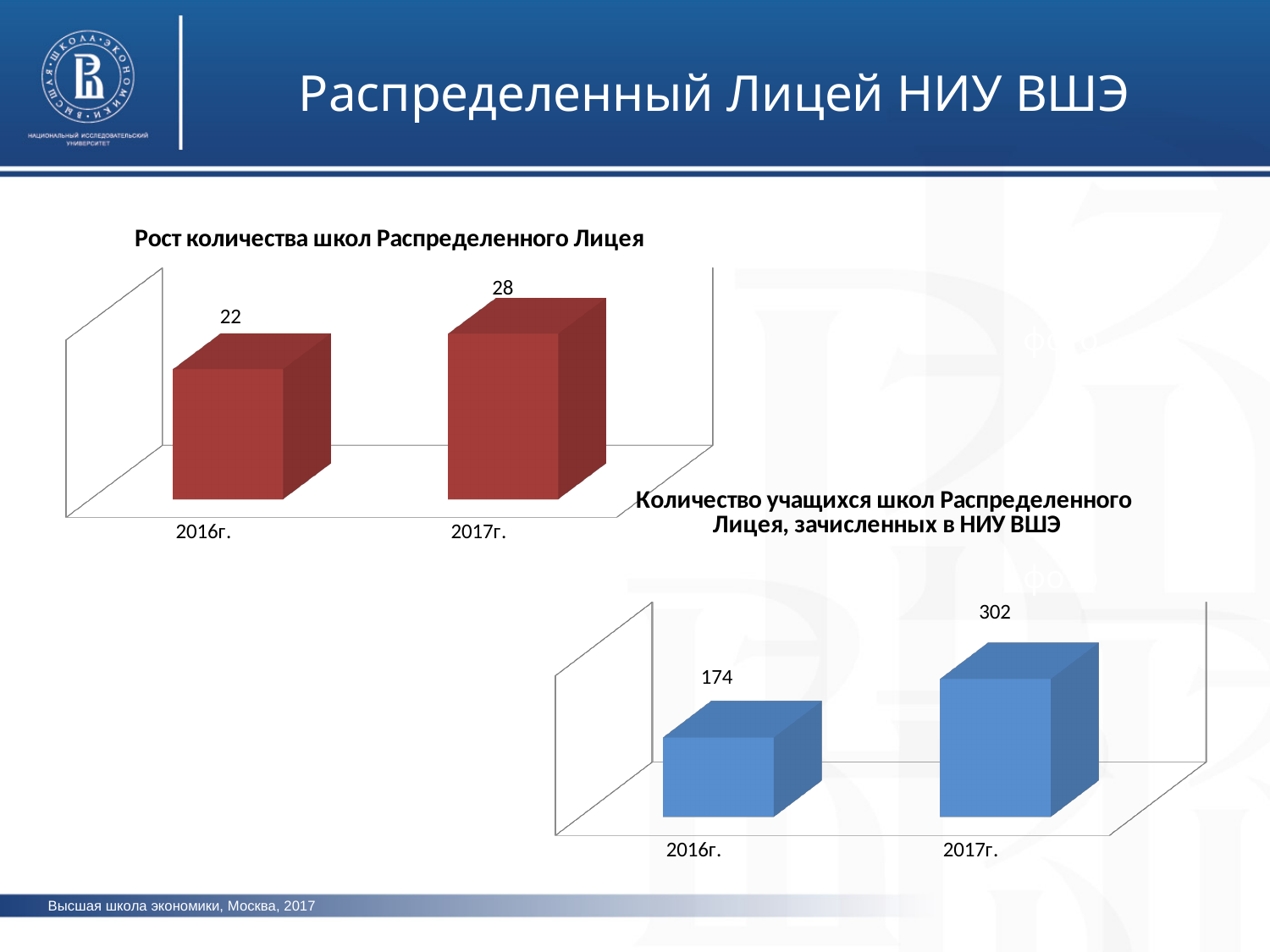
What kind of chart is 'Количество учащихся школ Распределенного Лицея, зачисленных в НИУ ВШЭ'? bar chart In the chart 'Количество учащихся школ Распределенного Лицея, зачисленных в НИУ ВШЭ', what is the value for 2017г.? 302 In the chart 'Количество учащихся школ Распределенного Лицея, зачисленных в НИУ ВШЭ', which year has the lower value? 2016г. In the chart 'Рост количества школ Распределенного Лицея', by how much does the value for 2017г. exceed the value for 2016г.? 6 In the chart 'Количество учащихся школ Распределенного Лицея, зачисленных в НИУ ВШЭ', do the values rise or fall from 2016г. to 2017г.? rise In the chart 'Рост количества школ Распределенного Лицея', which year has the higher value? 2017г. How many categories are shown in the chart 'Рост количества школ Распределенного Лицея'? 2 In the chart 'Рост количества школ Распределенного Лицея', what is the value for 2016г.? 22 In the chart 'Рост количества школ Распределенного Лицея', what is the value for 2017г.? 28 In the chart 'Количество учащихся школ Распределенного Лицея, зачисленных в НИУ ВШЭ', what is the value for 2016г.? 174 What colour are the bars in the chart 'Рост количества школ Распределенного Лицея'? red In the chart 'Количество учащихся школ Распределенного Лицея, зачисленных в НИУ ВШЭ', what is the difference between the 2017г. and 2016г. values? 128